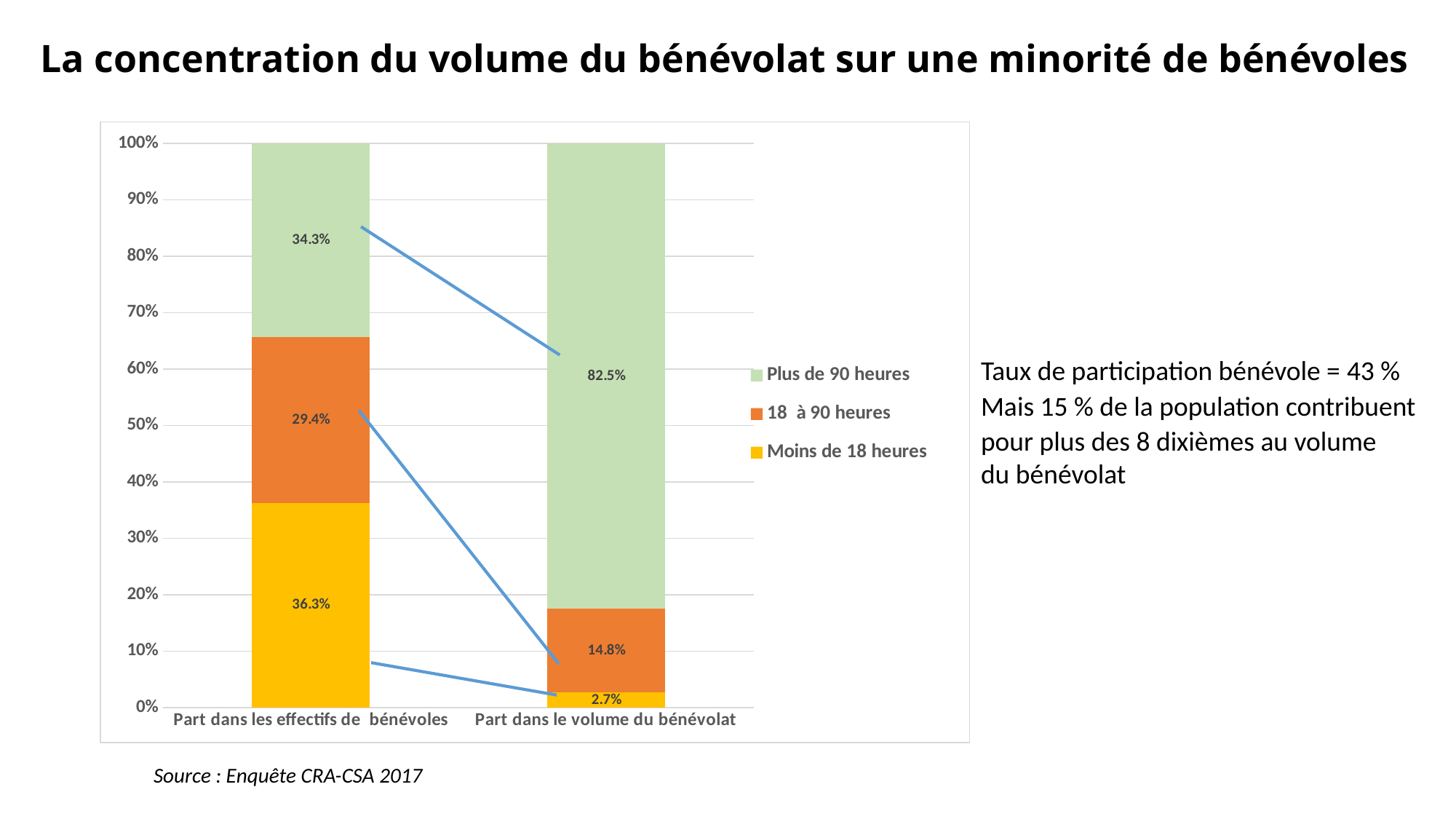
How many series does the legend list? 3 What is the value for 'Plus de 90 heures' in the 'Part dans les effectifs de bénévoles' bar? 34.3% Is the value for 'Moins de 18 heures' larger in 'Part dans les effectifs de bénévoles' or in 'Part dans le volume du bénévolat'? Part dans les effectifs de bénévoles How many categories are shown on the x axis? 2 What is the difference between the 'Plus de 90 heures' values in the two bars? 48.2% Which series has the smallest value in the 'Part dans le volume du bénévolat' bar? Moins de 18 heures What is the value for '18 à 90 heures' in the 'Part dans le volume du bénévolat' bar? 14.8% What kind of chart is shown on the slide? Stacked bar chart What is the value for 'Moins de 18 heures' in the 'Part dans les effectifs de bénévoles' bar? 36.3% What is the value for 'Plus de 90 heures' in the 'Part dans le volume du bénévolat' bar? 82.5% Which series has the largest value in the 'Part dans les effectifs de bénévoles' bar? Moins de 18 heures What colour represents 'Moins de 18 heures' in the chart? Yellow